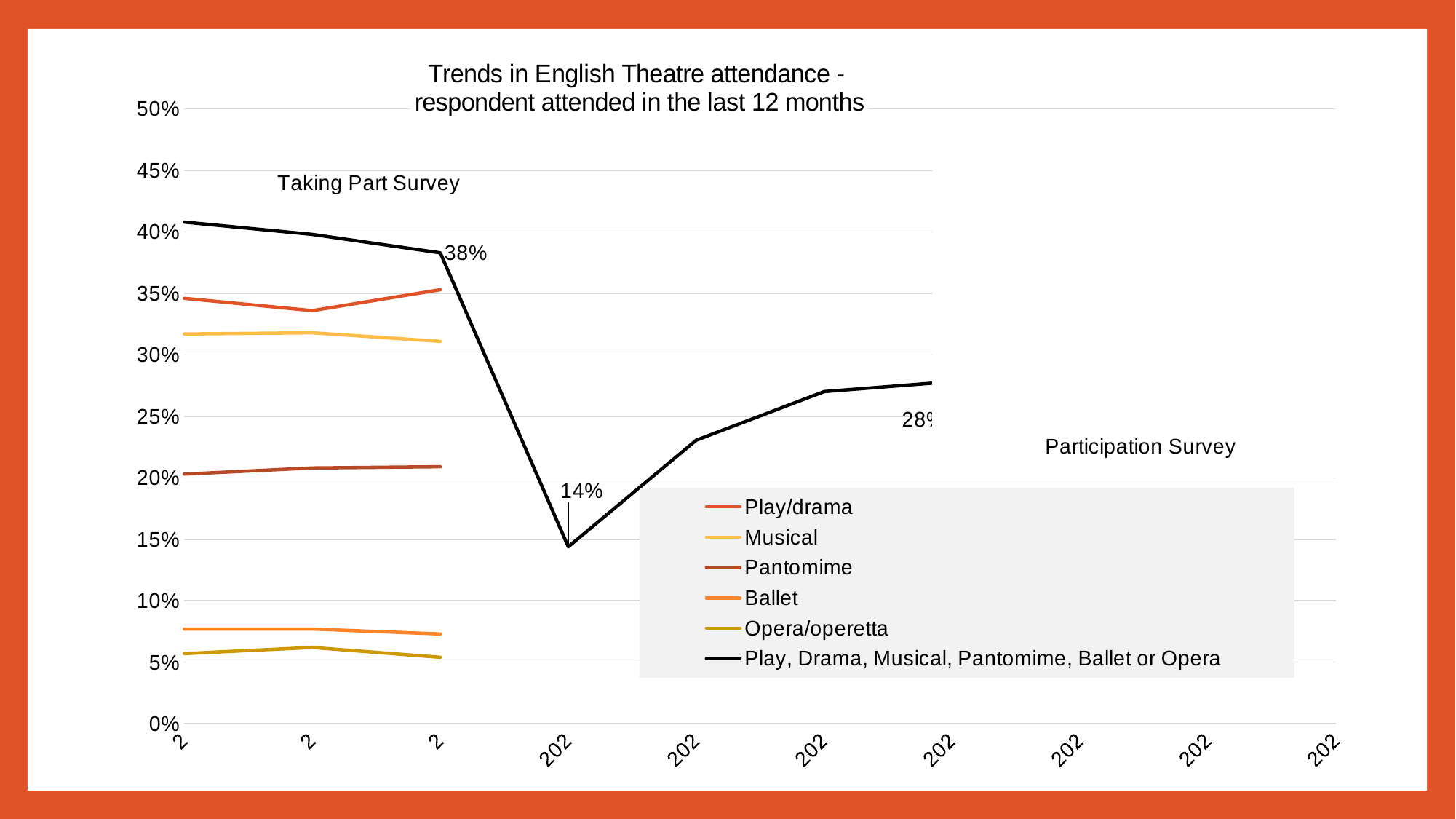
What is the lowest labelled value on the 'Play, Drama, Musical, Pantomime, Ballet or Opera' line? 14% What kind of chart is shown on the slide? line chart After the 14% low point, does the 'Play, Drama, Musical, Pantomime, Ballet or Opera' line rise or fall? rise Which series has the lowest values on the chart? Opera/operetta Is the value for Opera/operetta at its first point greater or less than 10%? less Which series is higher at the first point, Ballet or Opera/operetta? Ballet Is the value for Pantomime at its first point greater or less than 25%? less Which series is higher at the first point, Play/drama or Musical? Play/drama What is the difference between the 38% and 14% labelled values on the 'Play, Drama, Musical, Pantomime, Ballet or Opera' line? 24 percentage points How many series does the legend list? 6 What value is labelled at the last Taking Part Survey point of the 'Play, Drama, Musical, Pantomime, Ballet or Opera' line? 38% What is the title of the chart? Trends in English Theatre attendance - respondent attended in the last 12 months